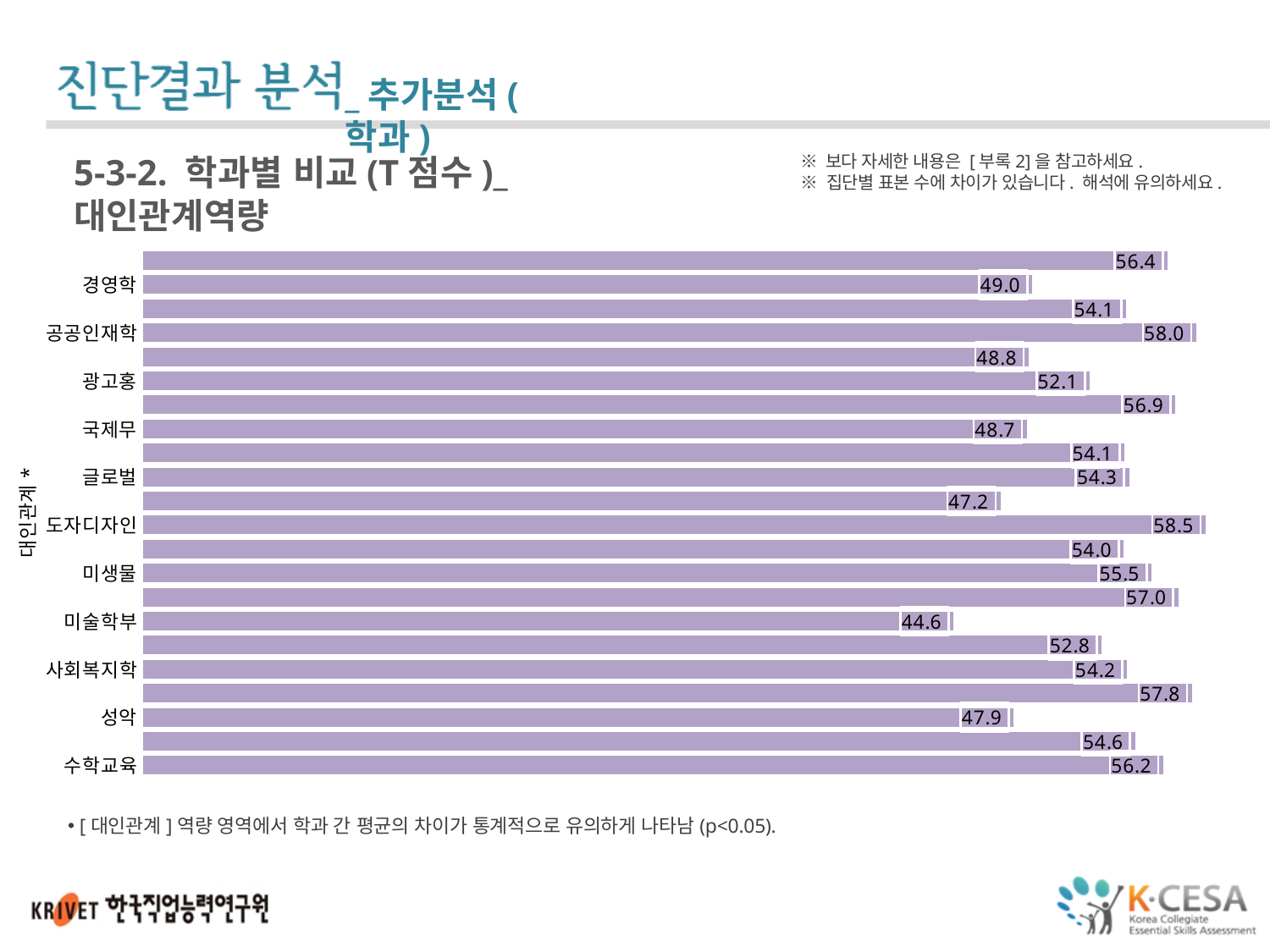
What is the value for 미술학부? 44.6 What kind of chart is shown on the slide? bar chart Which labeled category has the highest value? 도자디자인 What is the difference between the values for 도자디자인 and 미술학부? 13.9 What is the value for 경영학? 49.0 How many bars are plotted in the chart? 22 What is the label on the vertical axis of the chart? 대인관계 * What is the value for 수학교육? 56.2 What is the value for 성악? 47.9 Which is larger, the value for 글로벌 or the value for 국제무? 글로벌 What is the value for 공공인재학? 58.0 Which labeled category has the lowest value? 미술학부